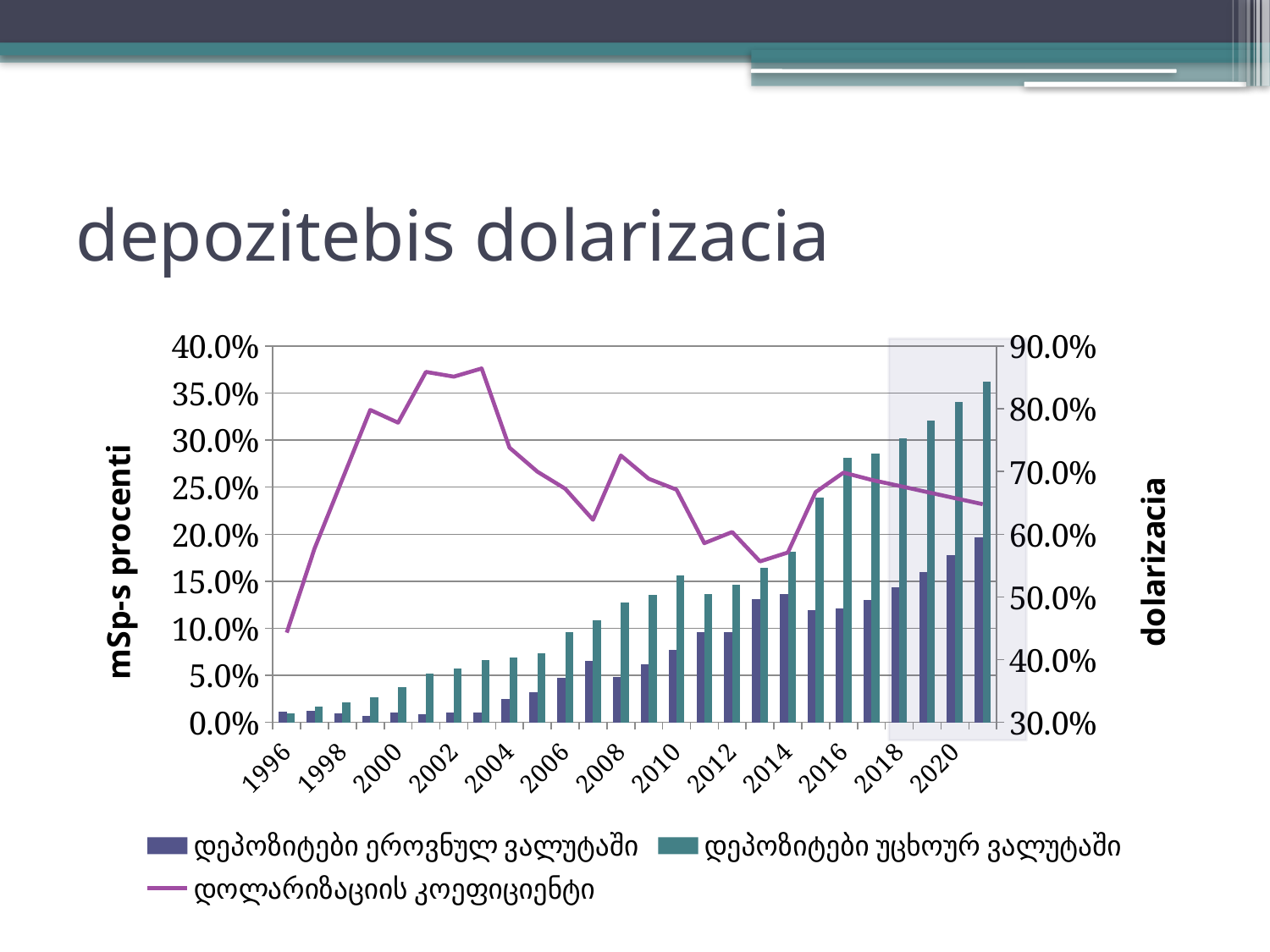
Is the tallest bar for დეპოზიტები უცხოურ ვალუტაში greater or less than 30.0%? greater Which bar series reaches the highest value on the chart? დეპოზიტები უცხოურ ვალუტაში Do the bars for დეპოზიტები უცხოურ ვალუტაში (foreign currency deposits) rise or fall from 1996 to the end of the series? rise In the last year shown, which is larger: the bar for დეპოზიტები ეროვნულ ვალუტაში or the bar for დეპოზიტები უცხოურ ვალუტაში? დეპოზიტები უცხოურ ვალუტაში What kind of chart is shown on the slide? Combined bar and line chart Is the lowest point of the დოლარიზაციის კოეფიციენტი line greater or less than 60.0%? less Is the value of the დოლარიზაციის კოეფიციენტი line in 1996 greater or less than 50.0%? less What is the title of the chart on the slide? depozitebis dolarizacia How many series does the legend list? 3 What is the title of the left vertical axis? mSp-s procenti What is the maximum value shown on the right vertical axis (dolarizacia)? 90.0%